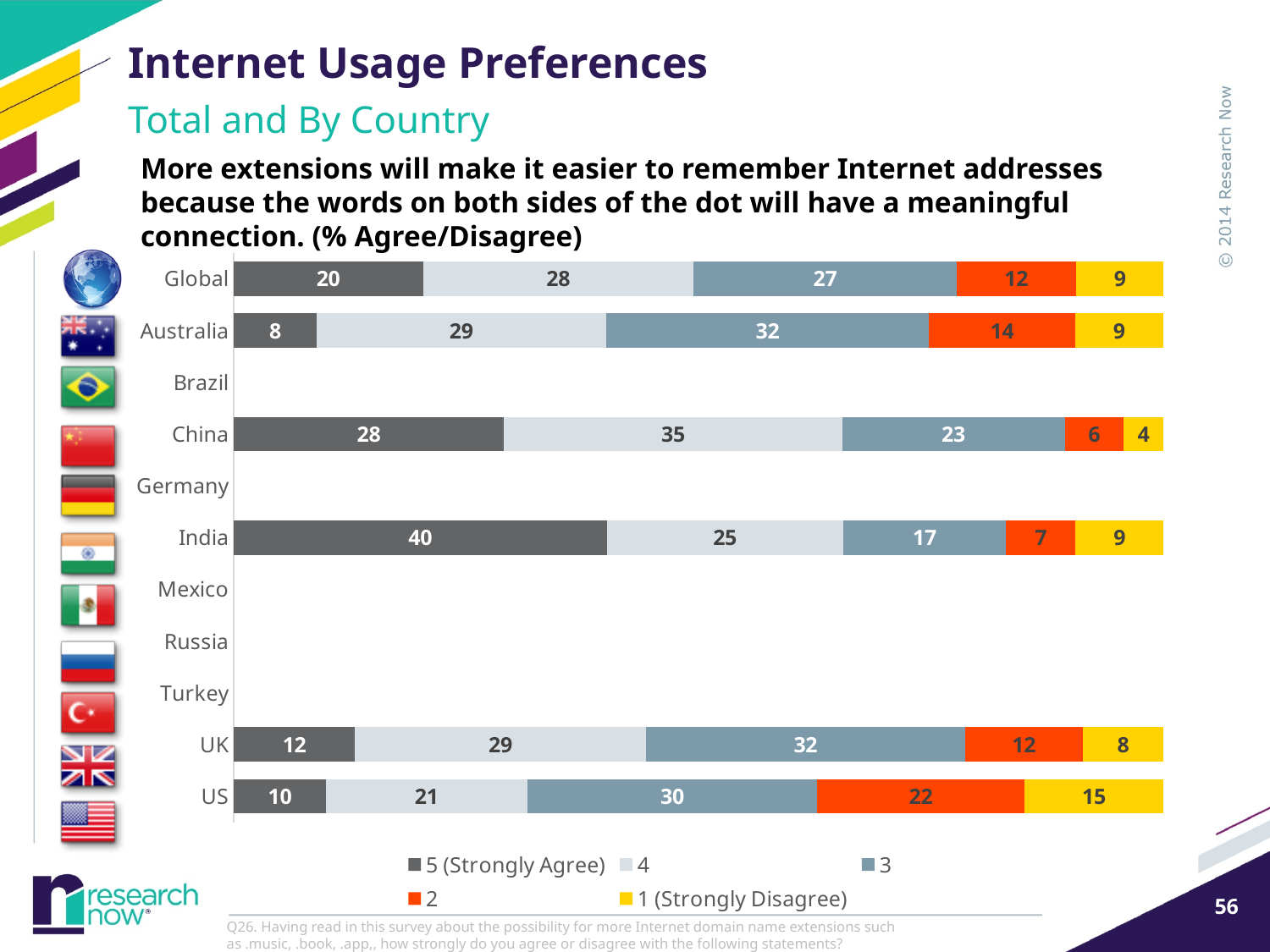
What percentage of respondents in India chose 5 (Strongly Agree)? 40 What is the value for the US in the 1 (Strongly Disagree) series? 15 Which country has the lowest value for 5 (Strongly Agree) among those with data shown? Australia Which is larger: the 3 series value for Australia or for Global? Australia Which legend entry is shown in yellow? 1 (Strongly Disagree) What is the difference between the 2 series values for the US and China? 16 Which country has the highest value for 1 (Strongly Disagree)? US What is the value for China in the 4 series? 35 Which country has the highest value for 5 (Strongly Agree)? India What is the total of the stacked bar for the UK? 93 How many series does the legend list? 5 What kind of chart is shown on the slide? Stacked bar chart